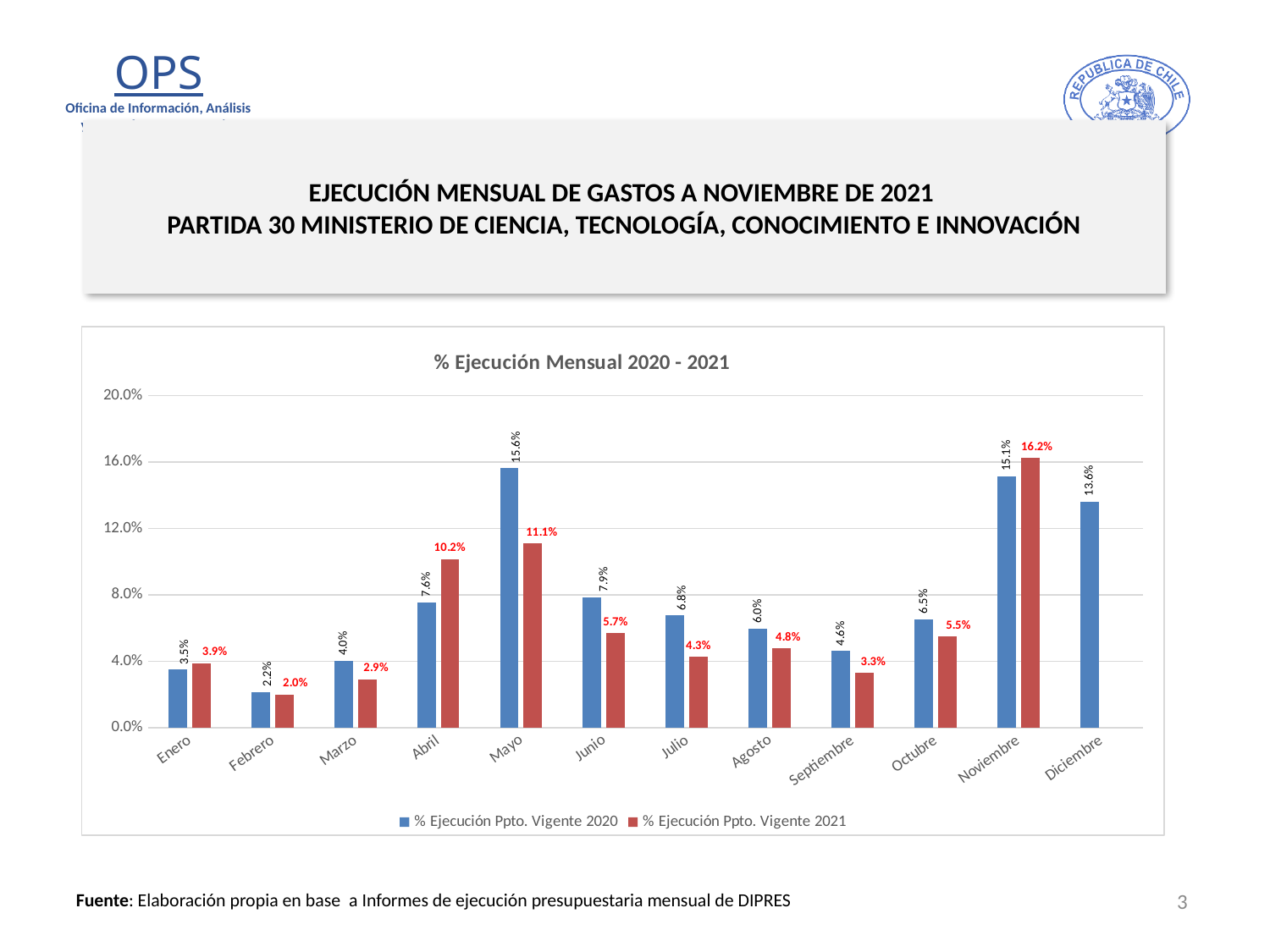
What is the value for Diciembre in the % Ejecución Ppto. Vigente 2020 series? 13.6% What is the value for Abril in the % Ejecución Ppto. Vigente 2021 series? 10.2% How many series does the legend list? 2 Which is larger for Noviembre: the % Ejecución Ppto. Vigente 2020 value or the % Ejecución Ppto. Vigente 2021 value? % Ejecución Ppto. Vigente 2021 What is the value for Mayo in the % Ejecución Ppto. Vigente 2020 series? 15.6% What type of chart is shown on the slide? Bar chart How many months are shown on the x axis? 12 What is the title of the chart? % Ejecución Mensual 2020 - 2021 Which month has the lowest value in the % Ejecución Ppto. Vigente 2020 series? Febrero Is the value for Abril in the % Ejecución Ppto. Vigente 2021 series greater or less than 8.0%? greater Which month has the highest value in the % Ejecución Ppto. Vigente 2021 series? Noviembre What is the difference between the 2020 and 2021 values for Mayo? 4.5%